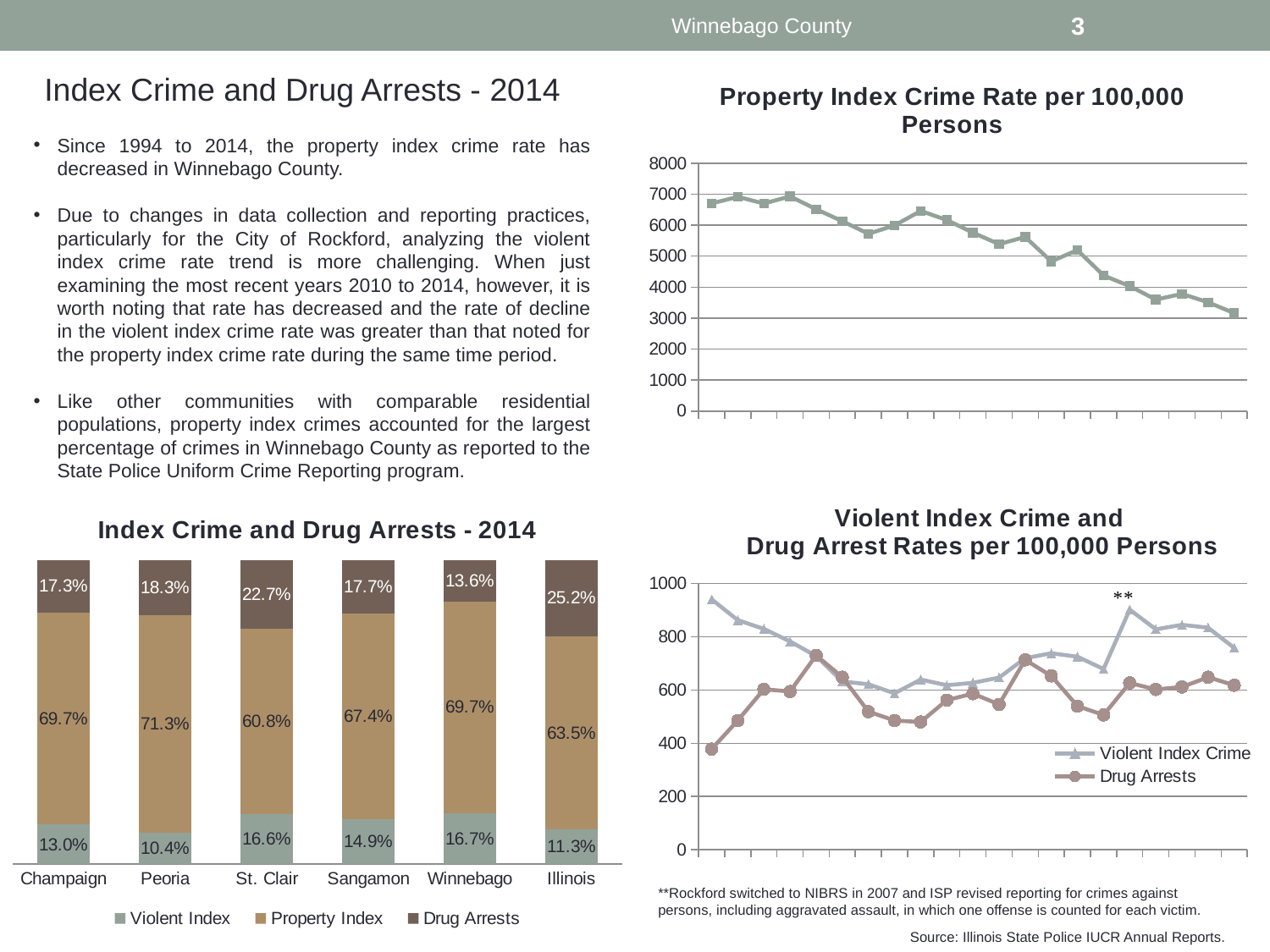
In the 'Property Index Crime Rate per 100,000 Persons' chart, do the values generally rise or fall from left to right? Fall How many series does the legend of the 'Index Crime and Drug Arrests - 2014' chart list? 3 In the 'Index Crime and Drug Arrests - 2014' chart, what is the difference between the Property Index percentages for Peoria and St. Clair? 10.5% In the 'Index Crime and Drug Arrests - 2014' chart, which is larger: the Violent Index value for Winnebago or for Sangamon? Winnebago In the 'Index Crime and Drug Arrests - 2014' chart, what is the Drug Arrests share for Illinois? 25.2% How many series does the legend of the 'Violent Index Crime and Drug Arrest Rates per 100,000 Persons' chart list? 2 In the 'Index Crime and Drug Arrests - 2014' chart, which category has the highest Drug Arrests percentage? Illinois In the 'Index Crime and Drug Arrests - 2014' chart, which category has the lowest Violent Index percentage? Peoria What kind of chart is 'Property Index Crime Rate per 100,000 Persons'? Line chart In the 'Index Crime and Drug Arrests - 2014' chart, what is the Violent Index value for Peoria? 10.4% In the 'Index Crime and Drug Arrests - 2014' chart, what percentage of Winnebago's bar is Property Index? 69.7% How many categories are shown on the x axis of the 'Index Crime and Drug Arrests - 2014' chart? 6